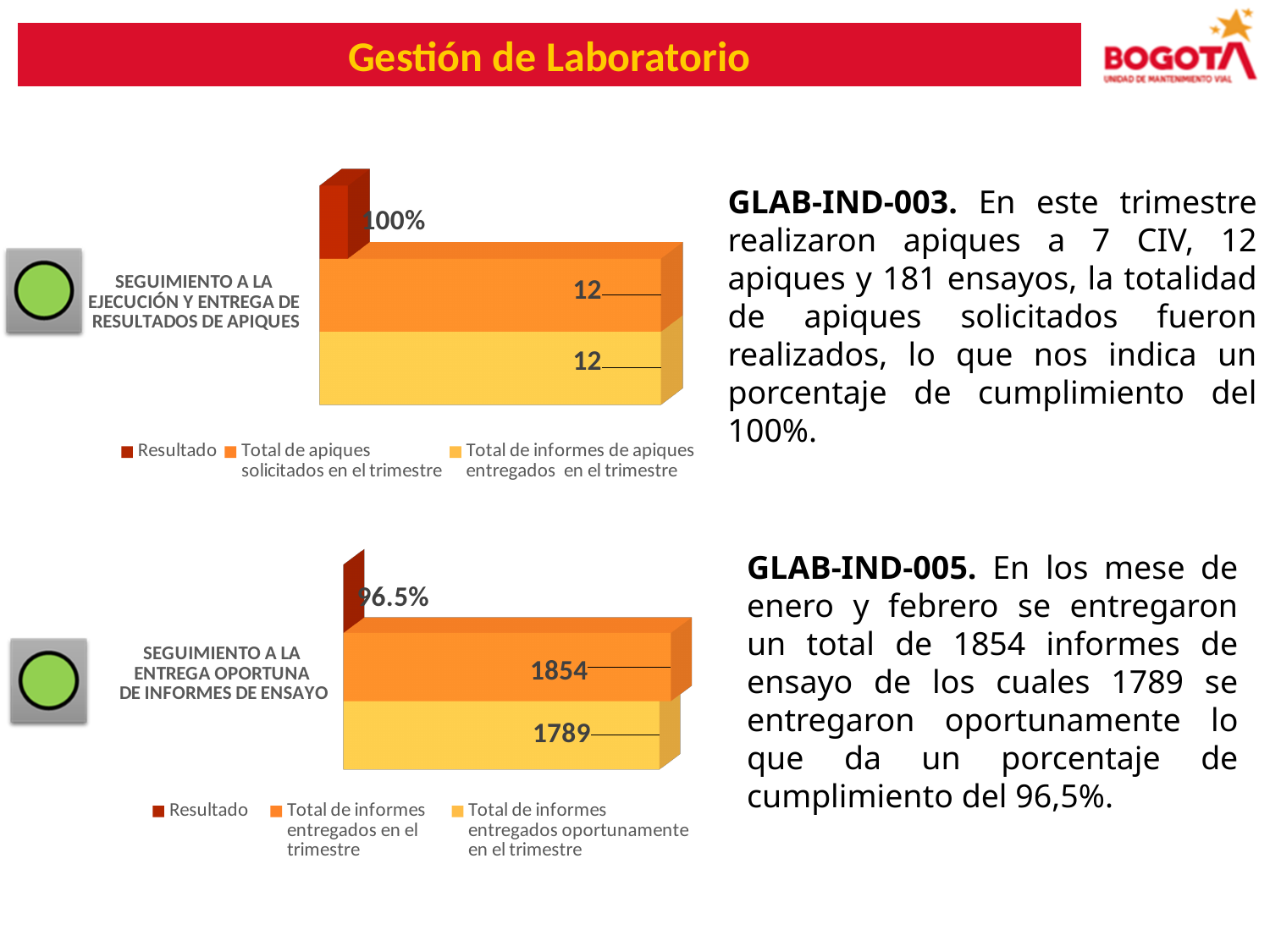
In the top chart, what colour is the bar for 'Resultado'? Dark red What kind of chart is the bottom chart (Seguimiento a la entrega oportuna de informes de ensayo)? Bar chart In the top chart (Seguimiento a la ejecución y entrega de resultados de apiques), what value is shown for 'Total de apiques solicitados en el trimestre'? 12 In the bottom chart (Seguimiento a la entrega oportuna de informes de ensayo), what value is shown for 'Total de informes entregados oportunamente en el trimestre'? 1789 In the top chart (Seguimiento a la ejecución y entrega de resultados de apiques), what value is shown for 'Resultado'? 100% In the bottom chart (Seguimiento a la entrega oportuna de informes de ensayo), which is larger: 'Total de informes entregados en el trimestre' or 'Total de informes entregados oportunamente en el trimestre'? Total de informes entregados en el trimestre In the bottom chart (Seguimiento a la entrega oportuna de informes de ensayo), what value is shown for 'Total de informes entregados en el trimestre'? 1854 In the top chart (Seguimiento a la ejecución y entrega de resultados de apiques), how many series does the legend list? 3 In the top chart (Seguimiento a la ejecución y entrega de resultados de apiques), what value is shown for 'Total de informes de apiques entregados en el trimestre'? 12 In the bottom chart (Seguimiento a la entrega oportuna de informes de ensayo), what is the difference between 'Total de informes entregados en el trimestre' and 'Total de informes entregados oportunamente en el trimestre'? 65 In the bottom chart (Seguimiento a la entrega oportuna de informes de ensayo), what value is shown for 'Resultado'? 96.5% In the bottom chart (Seguimiento a la entrega oportuna de informes de ensayo), how many series does the legend list? 3